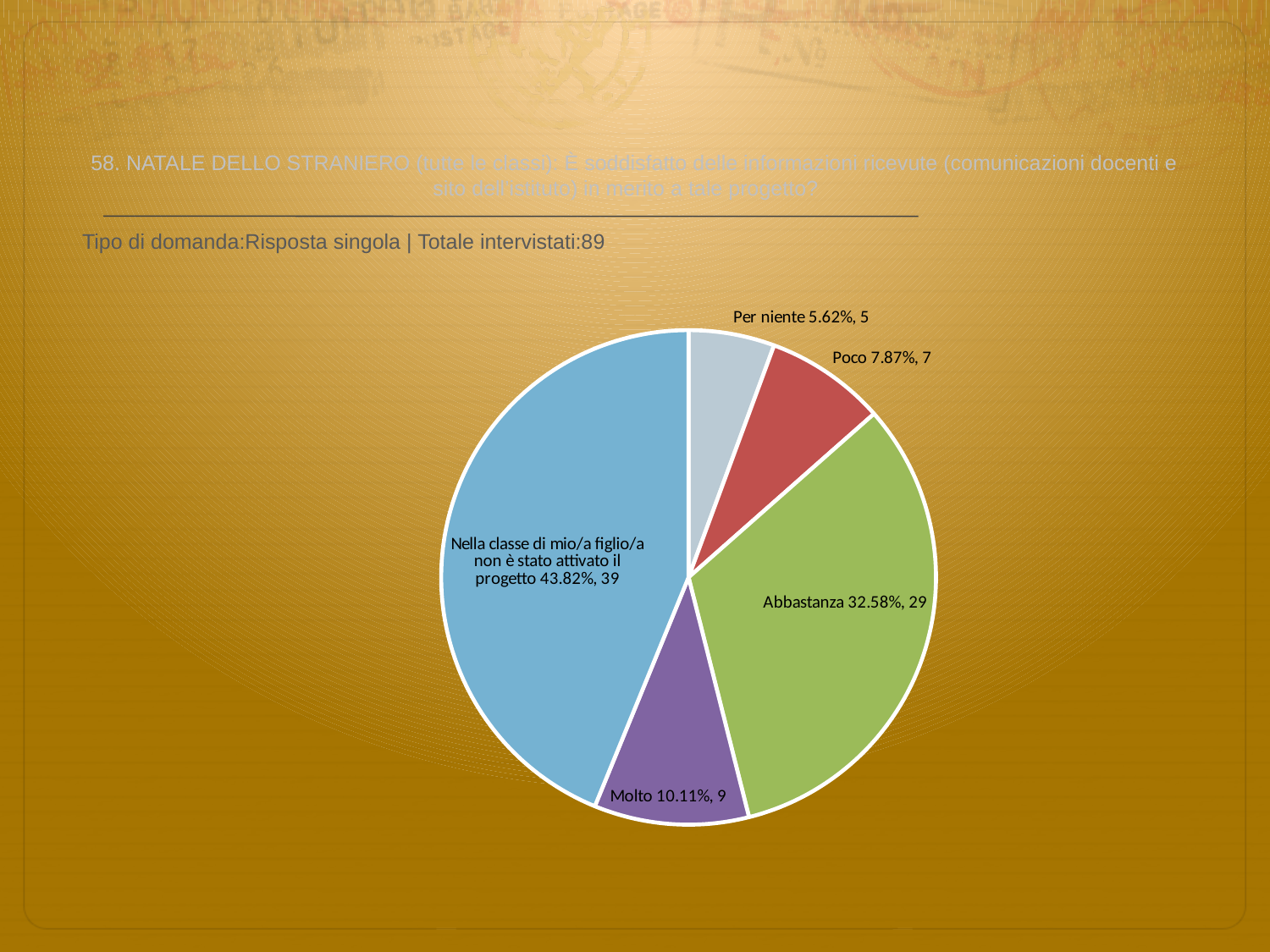
What is the percentage share of the 'Nella classe di mio/a figlio/a non è stato attivato il progetto' slice? 43.82% What percentage share does the 'Per niente' slice have? 5.62% Which slice is the largest? Nella classe di mio/a figlio/a non è stato attivato il progetto What is the count for the 'Abbastanza' slice? 29 What is the difference in count between 'Abbastanza' and 'Molto'? 20 What is the total number of respondents stated on the slide? 89 What percentage share does the 'Molto' slice have? 10.11% How many slices does the pie chart have? 5 Which slice is the smallest? Per niente What is the count for the 'Poco' slice? 7 Which has a larger count, 'Poco' or 'Per niente'? Poco What kind of chart is shown on the slide? pie chart